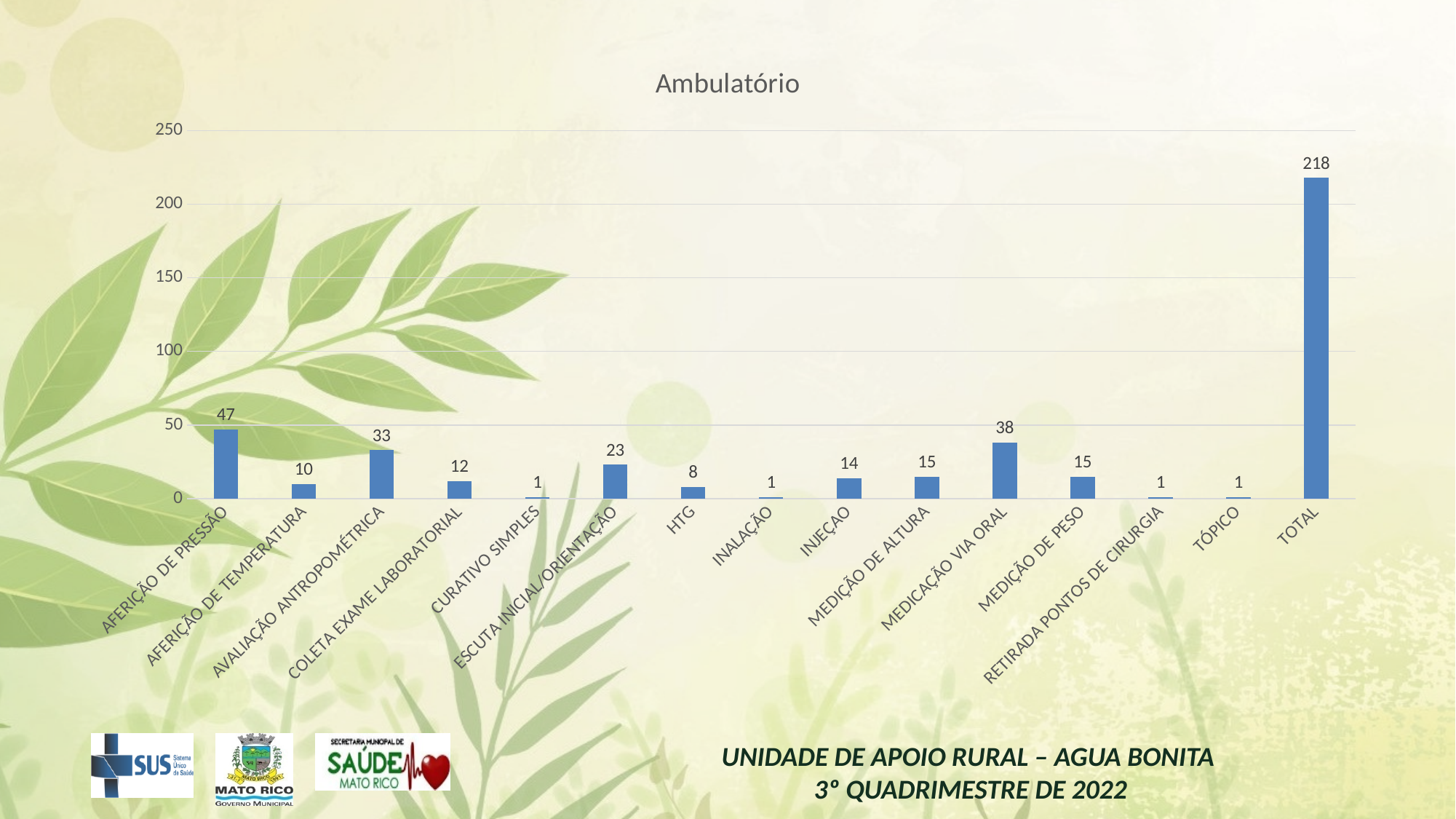
Which category has the tallest bar in the chart? TOTAL How many categories are shown on the x axis of the chart? 15 What is the difference between the values for AFERIÇÃO DE PRESSÃO and AVALIAÇÃO ANTROPOMÉTRICA? 14 What is the value for AFERIÇÃO DE PRESSÃO? 47 What is the value for TOTAL? 218 What is the title of the chart? Ambulatório What is the value for MEDICAÇÃO VIA ORAL? 38 Is the value for TOTAL greater or less than 200? greater Excluding TOTAL, which category has the highest value? AFERIÇÃO DE PRESSÃO What type of chart is shown on the slide? bar chart What is the value for ESCUTA INICIAL/ORIENTAÇÃO? 23 Which is larger, the value for INJEÇÃO or the value for HTG? INJEÇÃO